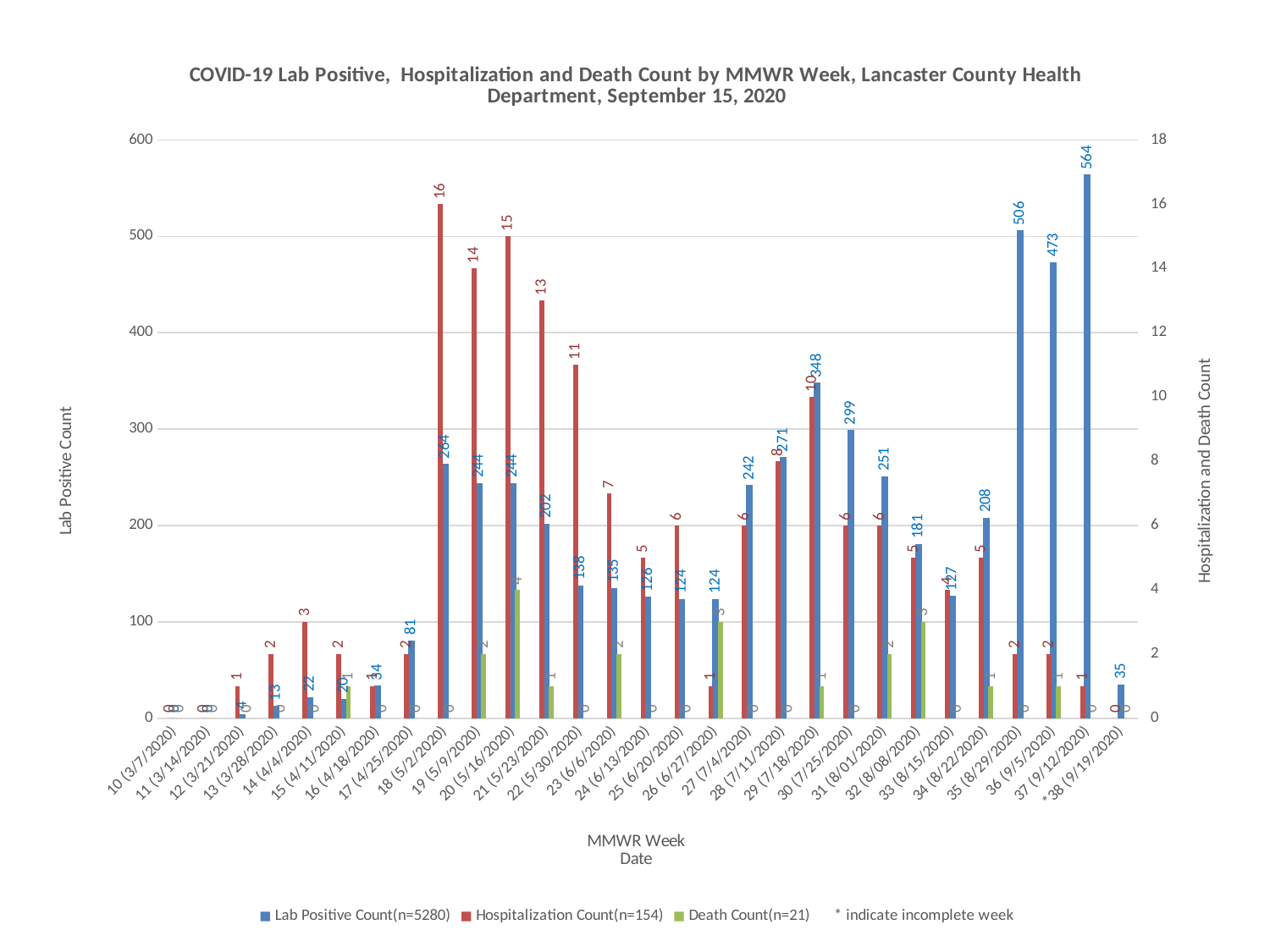
How many series does the legend list? 3 How many MMWR weeks are shown on the x axis? 29 What is the difference in Lab Positive Count between MMWR week 35 (8/29/2020) and week 36 (9/5/2020)? 33 Which is larger, the Lab Positive Count for week 28 (7/11/2020) or for week 30 (7/25/2020)? Week 30 (7/25/2020) Which MMWR week has the highest Hospitalization Count? 18 (5/2/2020) What is the Lab Positive Count for MMWR week 29 (7/18/2020)? 348 Is the Lab Positive Count for MMWR week 35 (8/29/2020) greater or less than 500? greater Which MMWR week has the highest Lab Positive Count? 37 (9/12/2020) What is the Hospitalization Count for MMWR week 18 (5/2/2020)? 16 What does the asterisk (*) next to week 38 indicate, according to the legend note? Incomplete week What is the Lab Positive Count for MMWR week 37 (9/12/2020)? 564 What kind of chart is shown on the slide? Bar chart